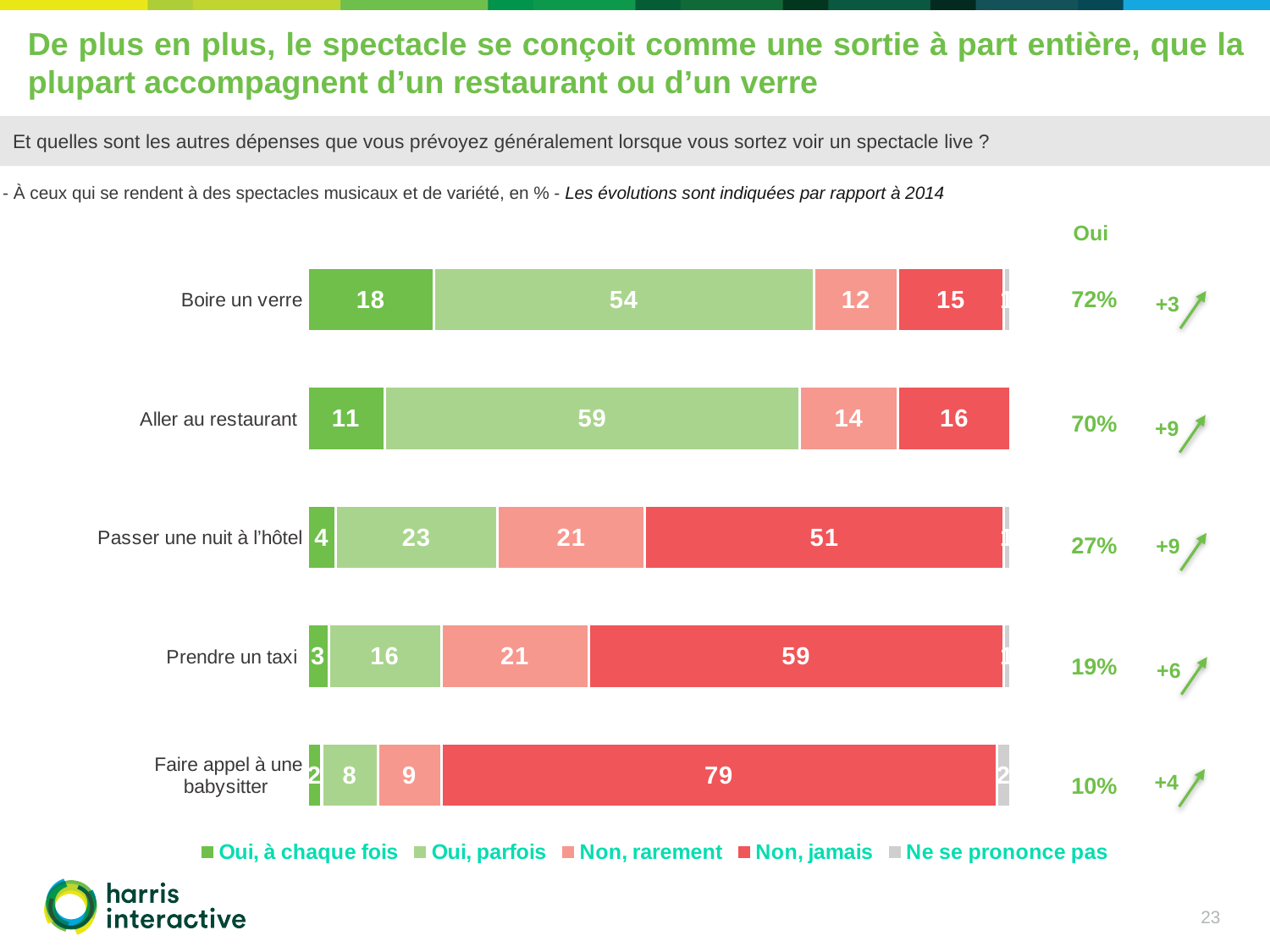
What is the "Oui" percentage shown for "Passer une nuit à l'hôtel"? 27% How many series does the legend list? 5 What kind of chart is shown on the slide? stacked bar chart How many categories (types of expense) does the chart show? 5 What is the value of "Non, jamais" for "Faire appel à une babysitter"? 79 What is the value of "Oui, parfois" for "Aller au restaurant"? 59 Which category has the highest "Non, jamais" value? Faire appel à une babysitter What evolution compared to 2014 is shown for "Aller au restaurant"? +9 Which is larger: the "Non, rarement" value for "Aller au restaurant" or for "Boire un verre"? Aller au restaurant Which category has the lowest "Oui" percentage? Faire appel à une babysitter What is the value of "Oui, à chaque fois" for "Boire un verre"? 18 What is the difference between the "Non, jamais" values for "Prendre un taxi" and "Passer une nuit à l'hôtel"? 8